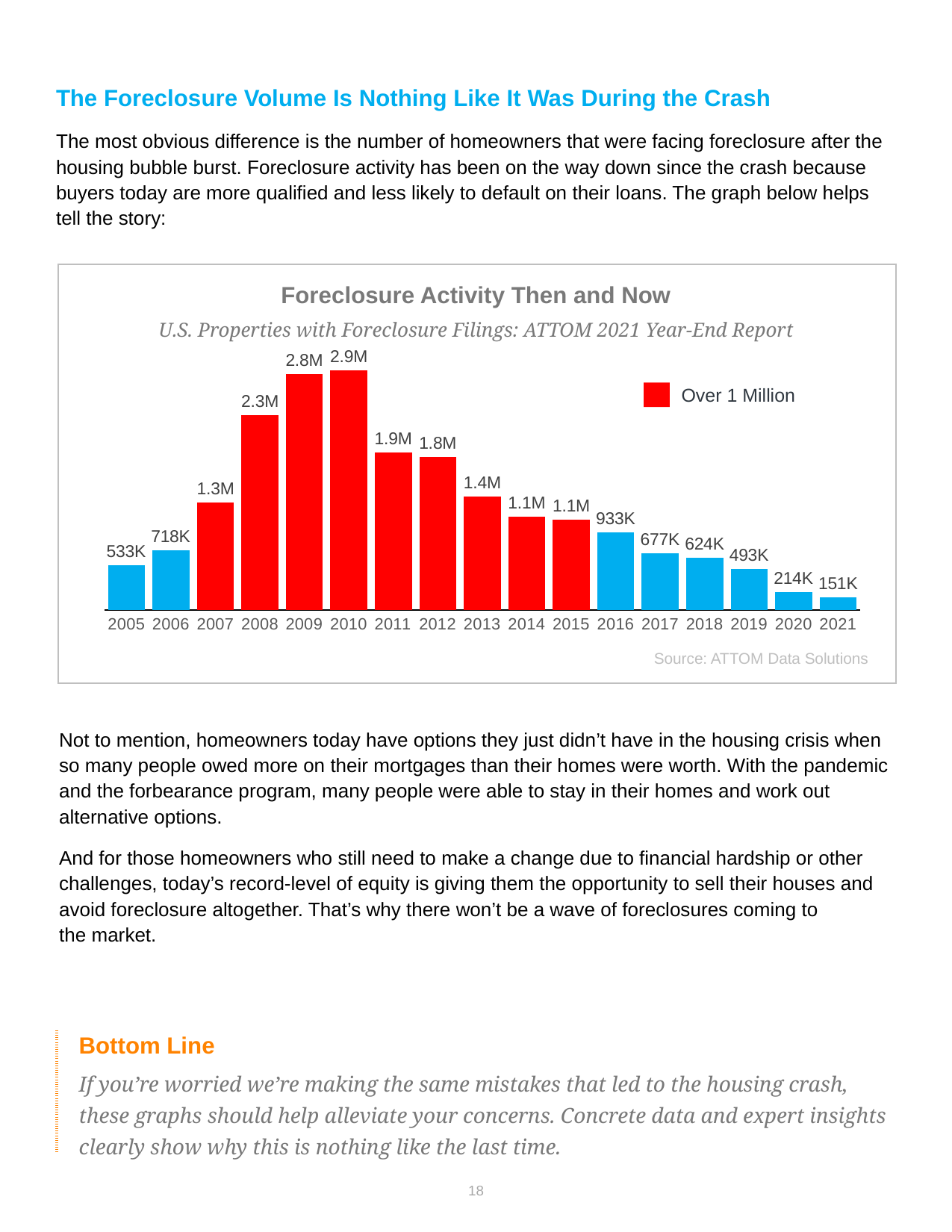
What is the difference between the values for 2017 and 2016? 256K Do the values rise or fall from 2010 to 2021? Fall What does the red colour in the legend represent? Over 1 Million Which year has the lowest foreclosure activity in the chart? 2021 What kind of chart is Foreclosure Activity Then and Now? Bar chart What value is shown for 2021 in the Foreclosure Activity Then and Now chart? 151K Which year has the larger value, 2007 or 2016? 2007 What was the number of U.S. properties with foreclosure filings in 2010? 2.9M What is the difference between the values for 2020 and 2021? 63K What value is shown for 2016? 933K Which year has the highest foreclosure activity in the chart? 2010 How many years are shown on the x axis of the chart? 17